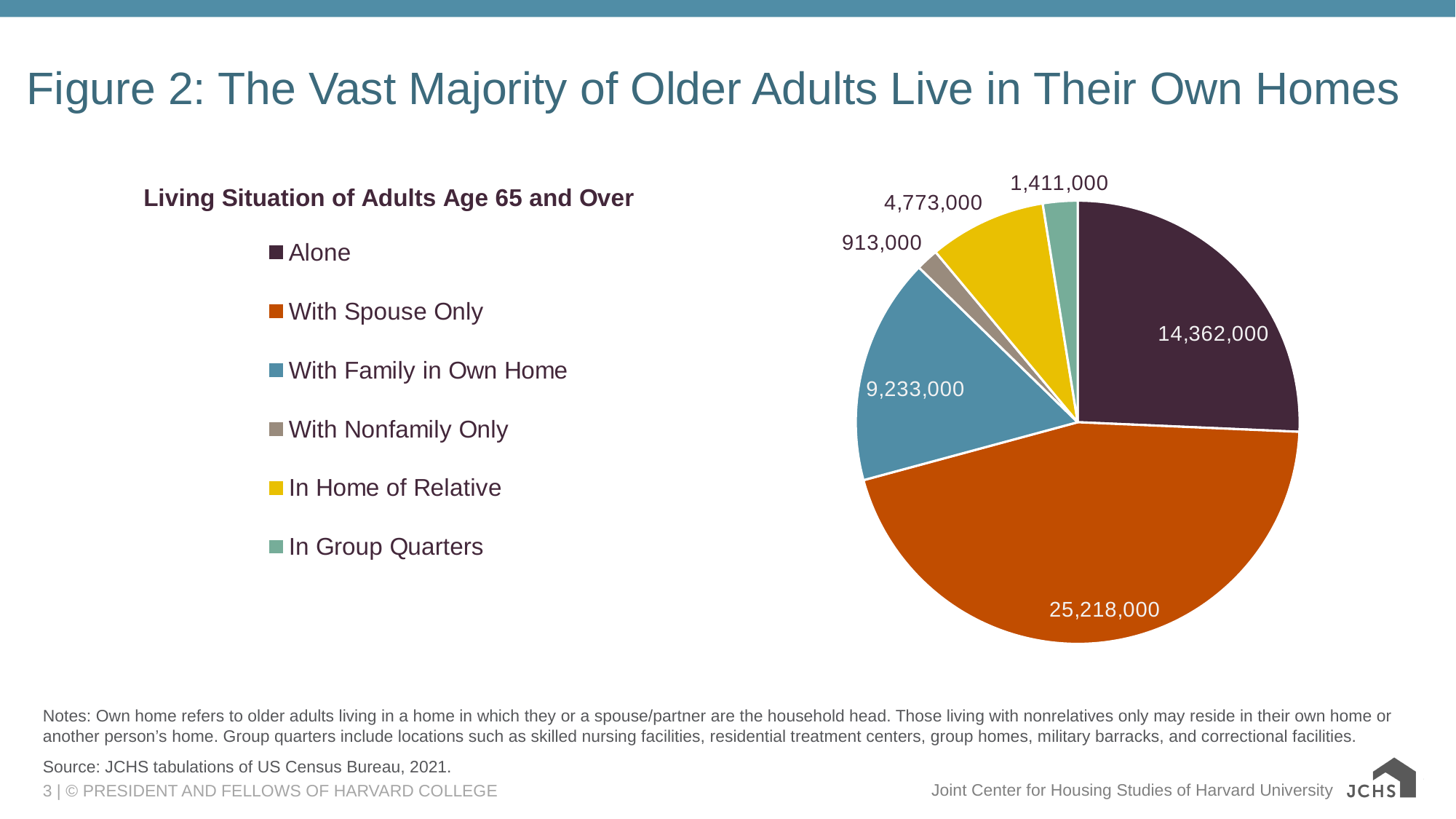
What is the difference between the values for With Spouse Only and Alone? 10,856,000 What is the difference between the values for In Home of Relative and In Group Quarters? 3,362,000 What is the value for With Family in Own Home? 9,233,000 Which is larger, the value for Alone or the value for With Family in Own Home? Alone What kind of chart is shown on the slide? Pie chart How many categories does the pie chart show? 6 What is the value for In Group Quarters? 1,411,000 What is the value for With Spouse Only? 25,218,000 Which living situation has the largest number of adults age 65 and over? With Spouse Only What is the title of the chart? Living Situation of Adults Age 65 and Over What is the value for With Nonfamily Only? 913,000 Which living situation has the smallest number of adults age 65 and over? With Nonfamily Only